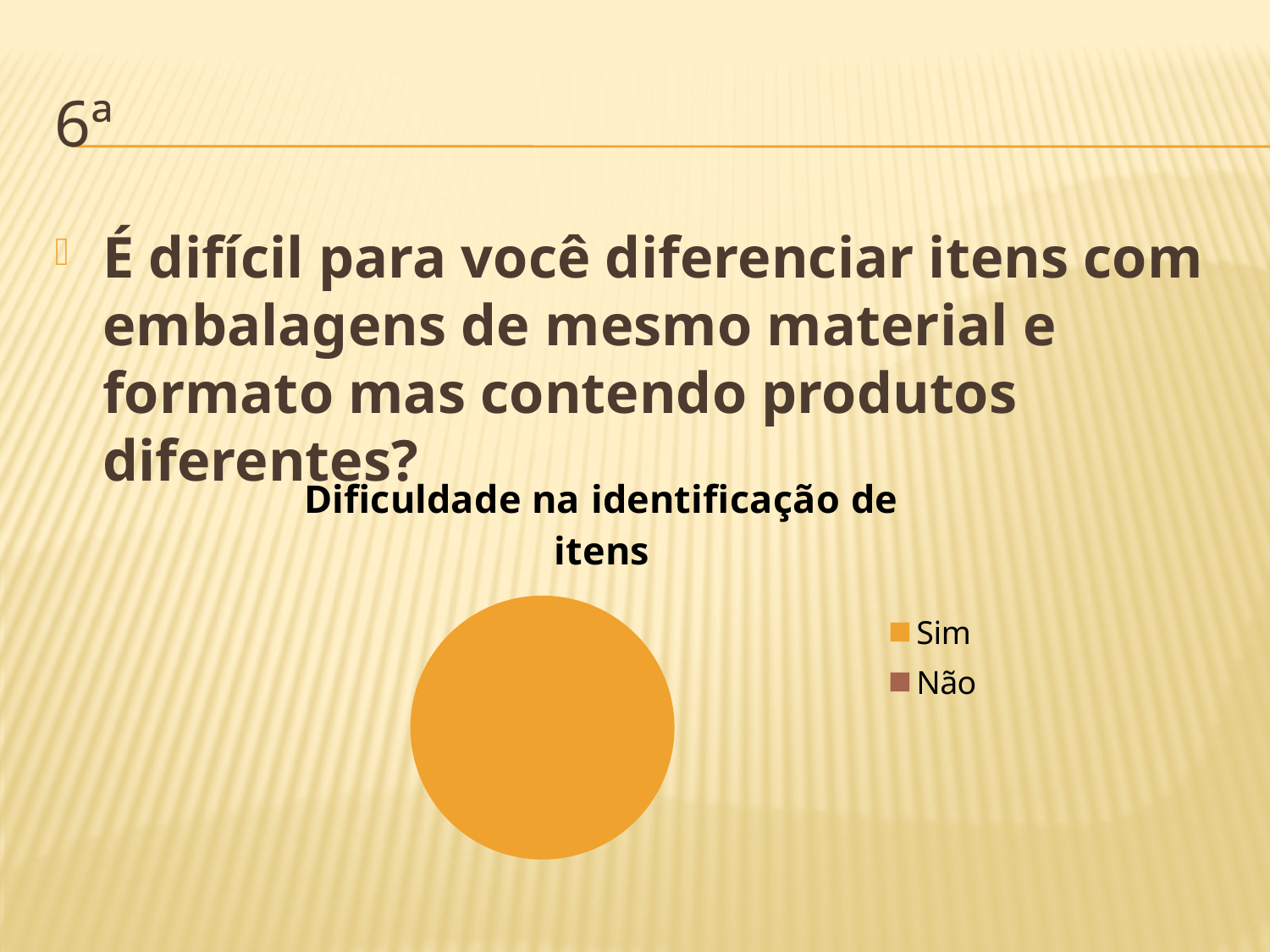
What kind of chart is shown on the slide? pie chart Which category takes up the largest share of the pie? Sim What colour represents the Sim category in the chart? orange What is the title of the chart? Dificuldade na identificação de itens How many entries does the chart's legend list? 2 Which category has the larger share of the pie, Sim or Não? Sim Which category takes up the smallest share of the pie? Não